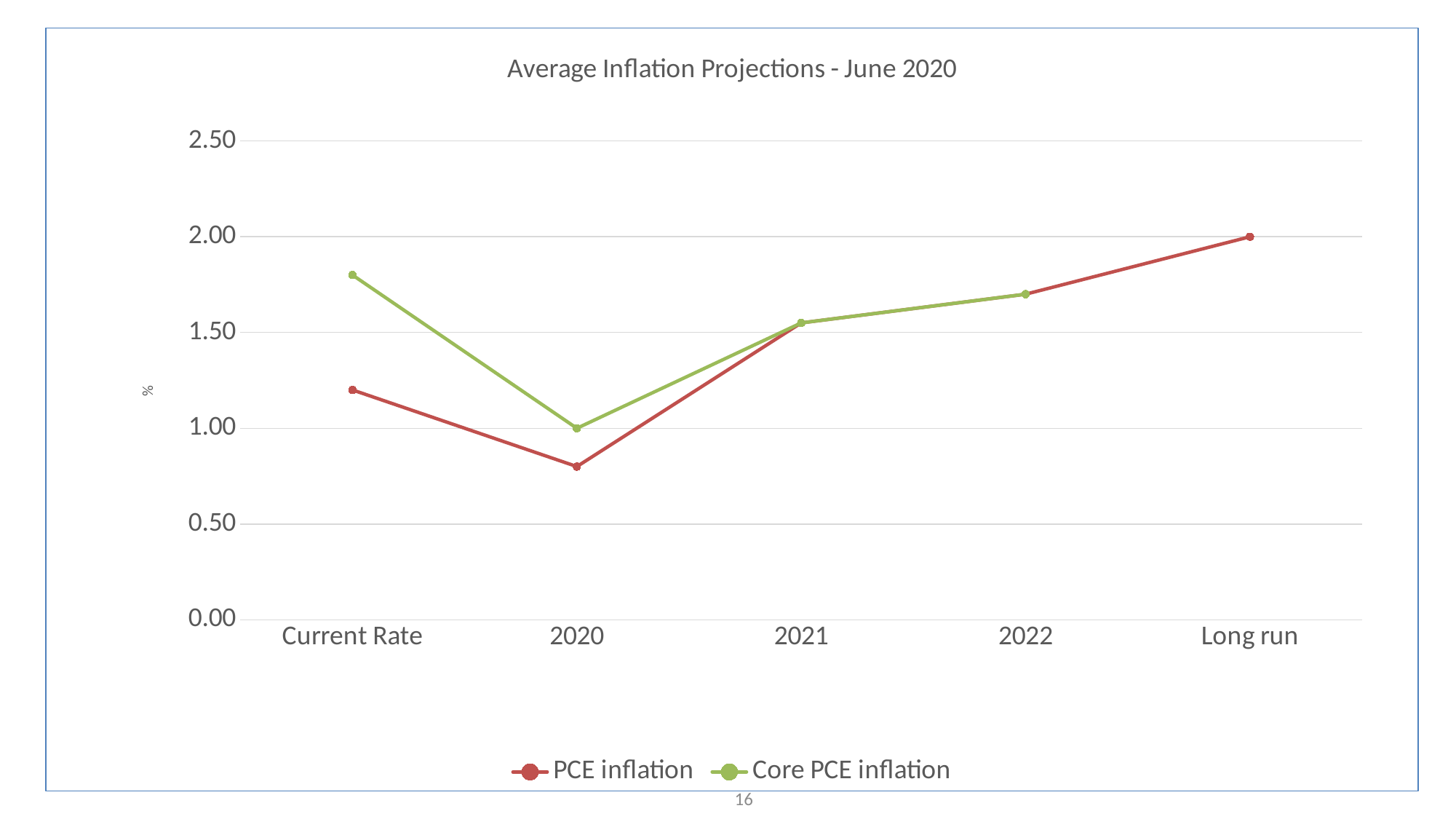
Which series has the higher value at Current Rate, PCE inflation or Core PCE inflation? Core PCE inflation How many series does the legend list? 2 What kind of chart is shown on the slide? line chart What is the value for PCE inflation in the Long run? 2.00 Is the value for Core PCE inflation at Current Rate greater or less than 1.50? greater What is the title of the chart? Average Inflation Projections - June 2020 In which category is PCE inflation lowest? 2020 What is the value for Core PCE inflation in 2020? 1.00 Is the value for PCE inflation in 2020 greater or less than 1.00? less How many categories are shown on the x axis? 5 Do the values for PCE inflation rise or fall from 2020 to Long run? rise Is the value for PCE inflation at Current Rate greater or less than 1.50? less